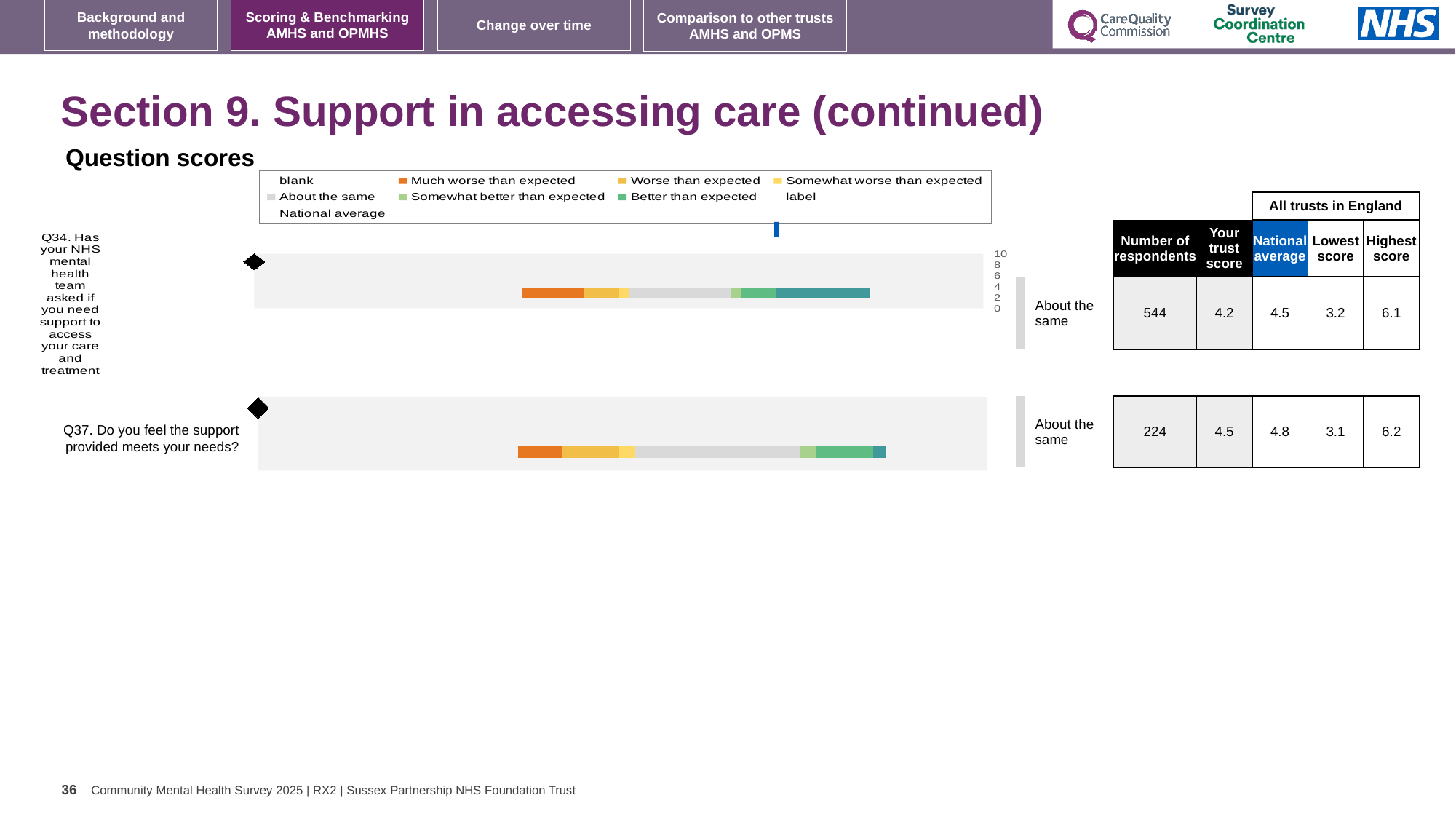
What colour does the legend use for 'Much worse than expected'? orange For Q34, how much higher is the national average than the trust score? 0.3 For Q34, what is the highest score among all trusts in England? 6.1 What benchmark category label is shown next to the Q37 bar? About the same What kind of chart is used to show the question scores for Q34 and Q37? bar chart For Q37, how many respondents are shown? 224 For Q34 (Has your NHS mental health team asked if you need support to access your care and treatment), what is the trust score shown? 4.2 For Q37 (Do you feel the support provided meets your needs?), what is the trust score shown? 4.5 Which question has the higher trust score, Q34 or Q37? Q37 For Q34, what is the national average score? 4.5 How many questions are plotted on the slide? 2 For Q37, what is the difference between the highest score and the lowest score among all trusts in England? 3.1